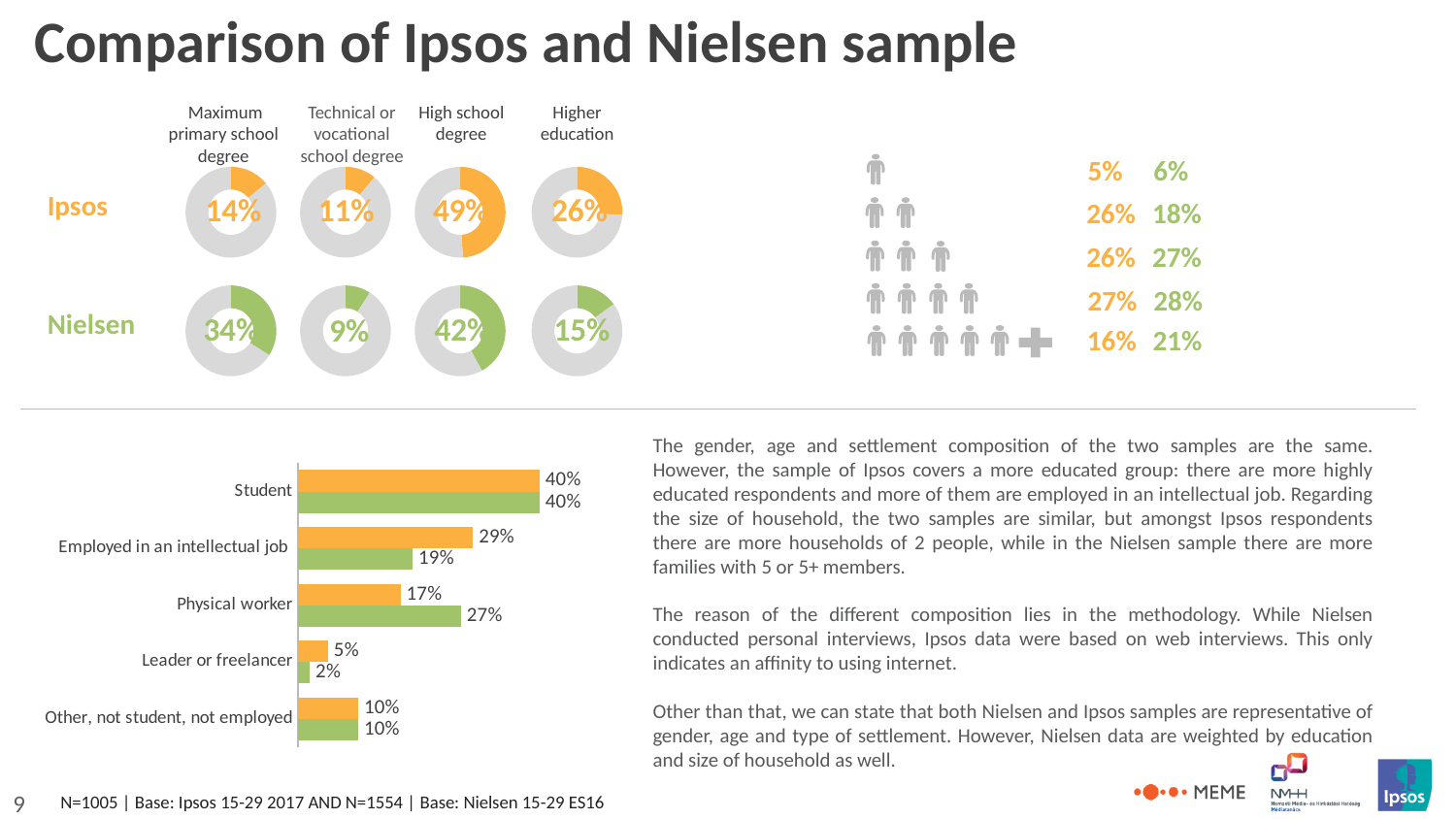
In the bar chart at the bottom left, what is the value of the orange (Ipsos) bar for Employed in an intellectual job? 29% In the bar chart at the bottom left, for Physical worker, which is larger: the orange (Ipsos) bar or the green (Nielsen) bar? Green (Nielsen) What type of chart is shown at the bottom left of the slide? Bar chart In the bar chart at the bottom left, which category has the highest orange (Ipsos) value? Student In the bar chart at the bottom left, what is the value of the green (Nielsen) bar for Physical worker? 27% How many categories does the bar chart at the bottom left show? 5 In the donut charts at the top, what share of the Nielsen sample has at most a primary school degree? 34% In the donut charts at the top, what share of the Ipsos sample has a high school degree? 49% In the bar chart at the bottom left, which category has the lowest green (Nielsen) value? Leader or freelancer In the donut charts at the top, what is the difference between the Ipsos and Nielsen shares for higher education? 11% In the household size figure at the top right, what is the Nielsen (green) value for households of 5 or more people? 21% In the bar chart at the bottom left, what is the difference between the orange and green bars for Employed in an intellectual job? 10%